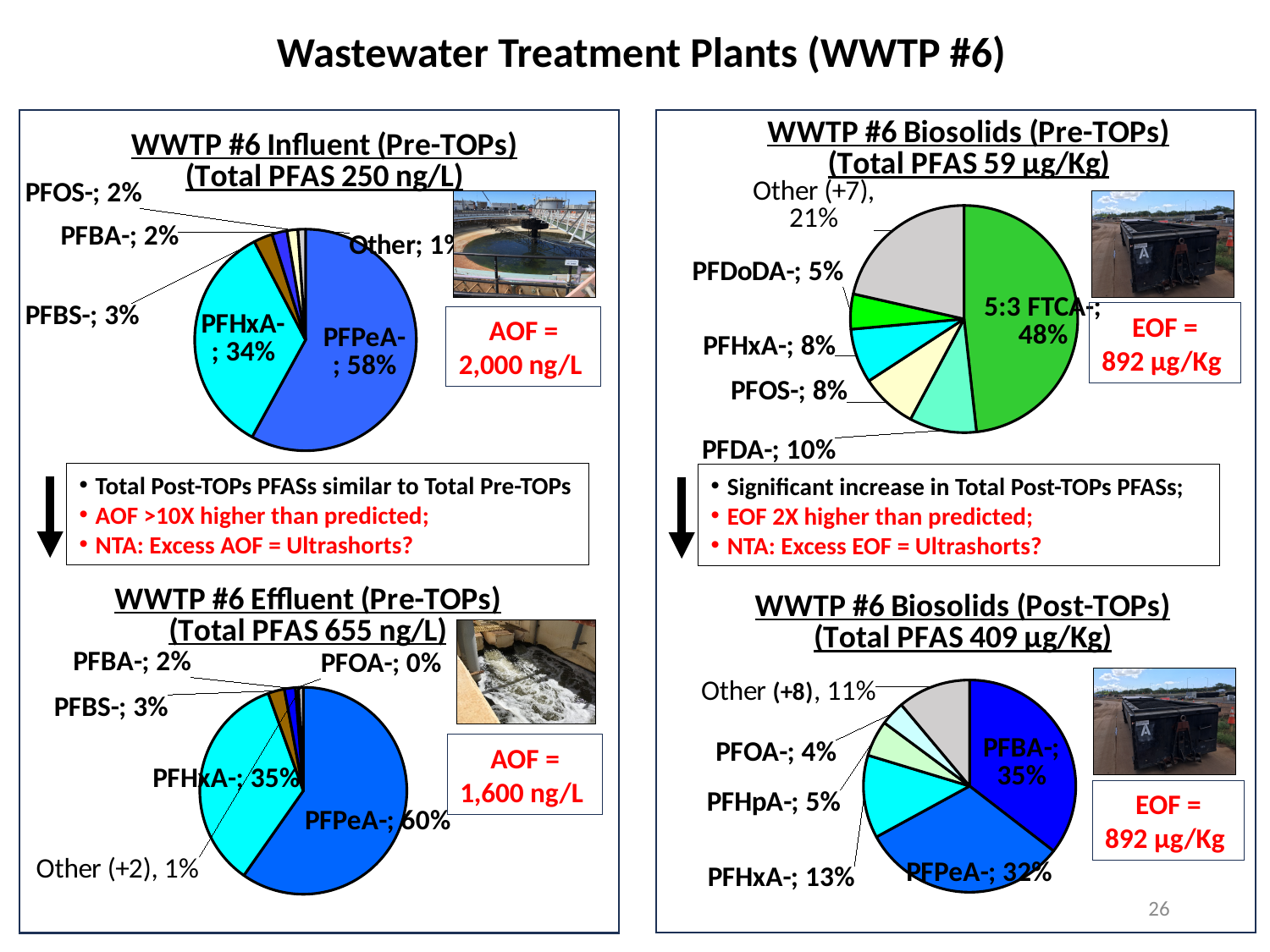
What total PFAS value is given in the title of the WWTP #6 Biosolids (Post-TOPs) chart? 409 µg/Kg In the WWTP #6 Effluent (Pre-TOPs) chart, how many slices are labelled? 6 In the WWTP #6 Biosolids (Post-TOPs) chart, what share does PFHxA- have? 13% In the WWTP #6 Biosolids (Pre-TOPs) chart, which is larger, PFDA- or PFOS-? PFDA- In the WWTP #6 Biosolids (Post-TOPs) chart, which category has the largest slice? PFBA- In the WWTP #6 Influent (Pre-TOPs) chart, what share does PFPeA- have? 58% In the WWTP #6 Biosolids (Pre-TOPs) chart, what share does 5:3 FTCA- have? 48% In the WWTP #6 Influent (Pre-TOPs) chart, which category has the largest slice? PFPeA- In the WWTP #6 Biosolids (Pre-TOPs) chart, which category has the smallest slice? PFDoDA- In the WWTP #6 Effluent (Pre-TOPs) chart, what share does PFHxA- have? 35% In the WWTP #6 Influent (Pre-TOPs) chart, what is the difference in percentage points between PFPeA- and PFHxA-? 24 What kind of chart is the WWTP #6 Effluent (Pre-TOPs) chart? pie chart